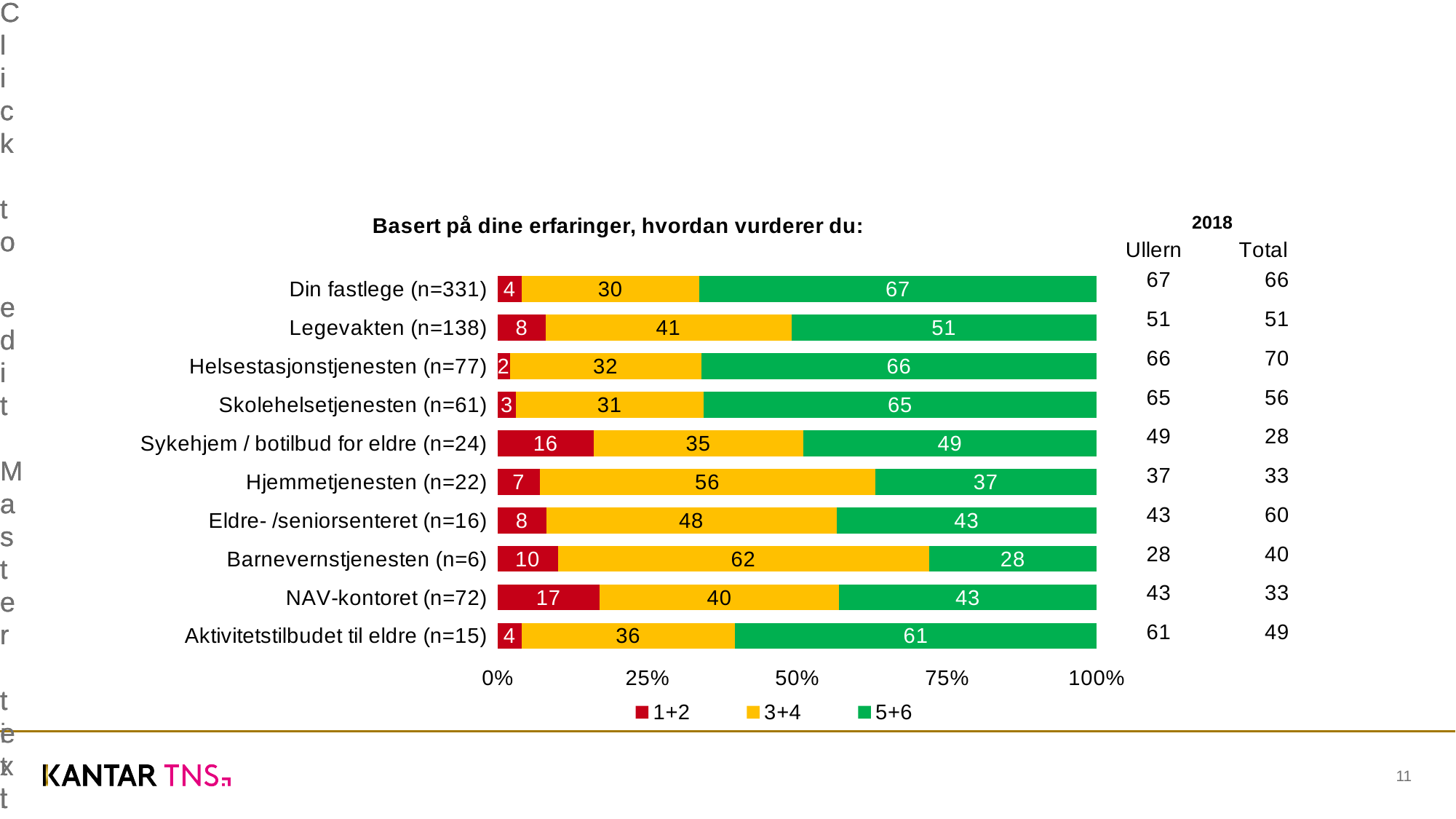
Which category has the highest value in the 3+4 series? Barnevernstjenesten (n=6) What is the value of the 1+2 series for NAV-kontoret (n=72)? 17 What is the value of the 3+4 series for Hjemmetjenesten (n=22)? 56 Which category has the highest value in the 5+6 series? Din fastlege (n=331) How many categories are shown in the chart? 10 Which has a larger 5+6 value, Sykehjem / botilbud for eldre (n=24) or Hjemmetjenesten (n=22)? Sykehjem / botilbud for eldre (n=24) Which category has the lowest value in the 5+6 series? Barnevernstjenesten (n=6) What is the difference between the 5+6 values for Din fastlege (n=331) and Legevakten (n=138)? 16 How many series does the legend list? 3 What kind of chart is shown on the slide? Stacked bar chart What is the value of the 5+6 series for Din fastlege (n=331)? 67 What is the difference between the 3+4 values for Barnevernstjenesten (n=6) and Hjemmetjenesten (n=22)? 6